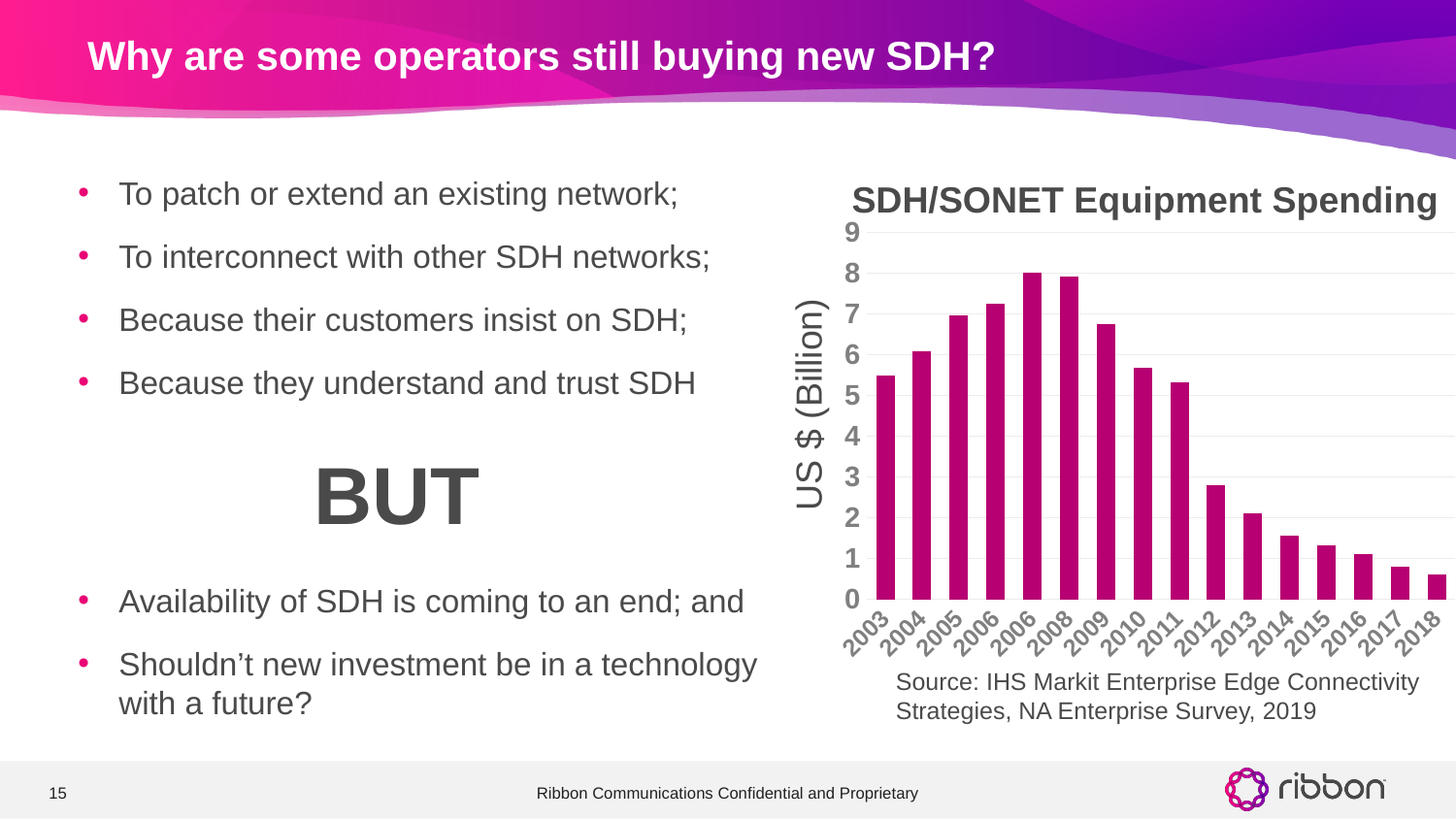
Which year has higher spending, 2004 or 2013? 2004 What is the title of the chart? SDH/SONET Equipment Spending Is the value for 2009 greater or less than 6? greater Is the value for 2003 greater or less than 5? greater Is the value for 2012 greater or less than 3? less What is the label on the vertical axis of the chart? US $ (Billion) How many bars are plotted in the chart? 16 What type of chart is shown on the slide? bar chart Do the values rise or fall from 2008 to 2018? fall Which year has the lowest SDH/SONET equipment spending? 2018